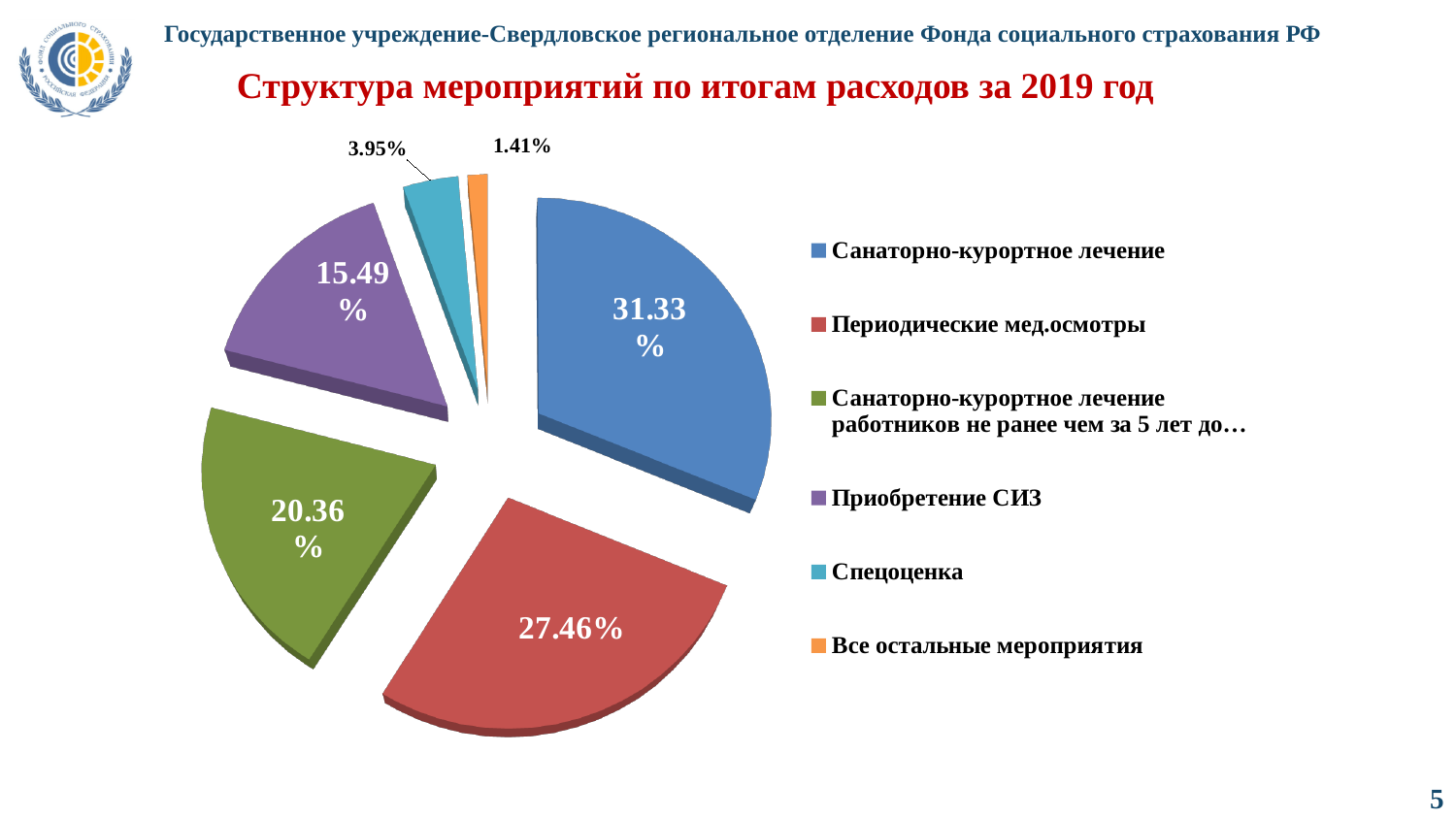
Which is larger: the share for Приобретение СИЗ or the share for Спецоценка? Приобретение СИЗ What share is shown for Все остальные мероприятия? 1.41% What is the value for Спецоценка? 3.95% What is the difference between the shares of Санаторно-курортное лечение and Периодические мед.осмотры? 3.87% Which category has the smallest share of the pie? Все остальные мероприятия What is the value shown for Периодические мед.осмотры? 27.46% Which category has the largest share of the pie? Санаторно-курортное лечение What is the title of the chart? Структура мероприятий по итогам расходов за 2019 год How many categories are shown in the pie chart? 6 What type of chart is shown on the slide? Pie chart What percentage is shown for Приобретение СИЗ? 15.49% What share of expenses does Санаторно-курортное лечение account for? 31.33%